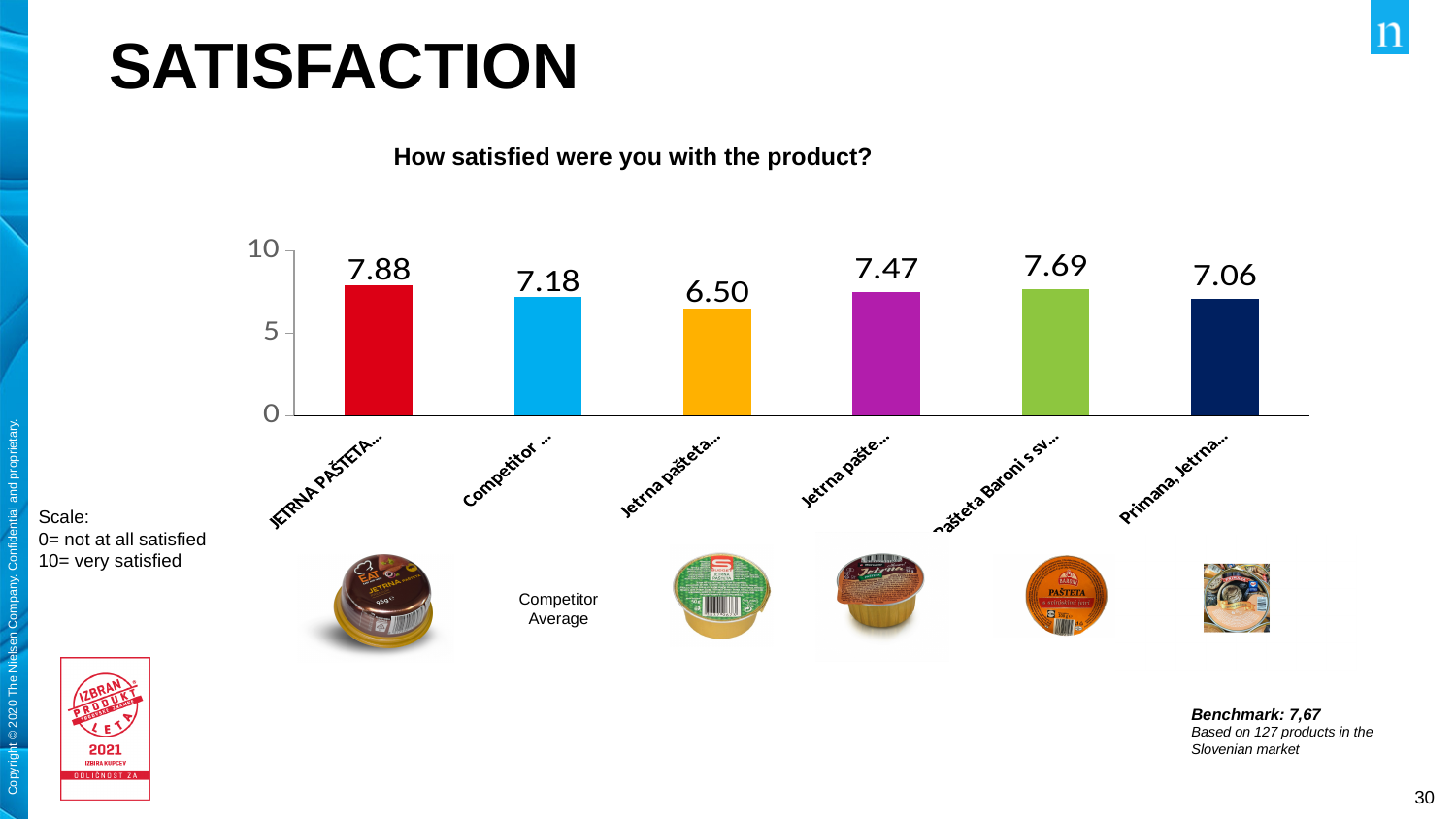
What is the value shown on the first (red) bar, JETRNA PAŠTETA? 7.88 Which is larger, the value for Pašteta Baroni or the value for Primana, Jetrna? Pašteta Baroni What is the benchmark value stated on the slide? 7,67 Which bar has the lowest satisfaction value? the third (yellow) bar, 6.50 What is the difference between the highest value (7.88) and the Competitor value (7.18)? 0.70 What is the satisfaction value for Pašteta Baroni? 7.69 What is the satisfaction value for Primana, Jetrna? 7.06 What is the satisfaction value for the Competitor bar? 7.18 How many bars are plotted in the chart? 6 What is the value shown on the third (yellow) bar? 6.50 What type of chart is shown on the slide? bar chart Which bar has the highest satisfaction value? JETRNA PAŠTETA (first bar, 7.88)